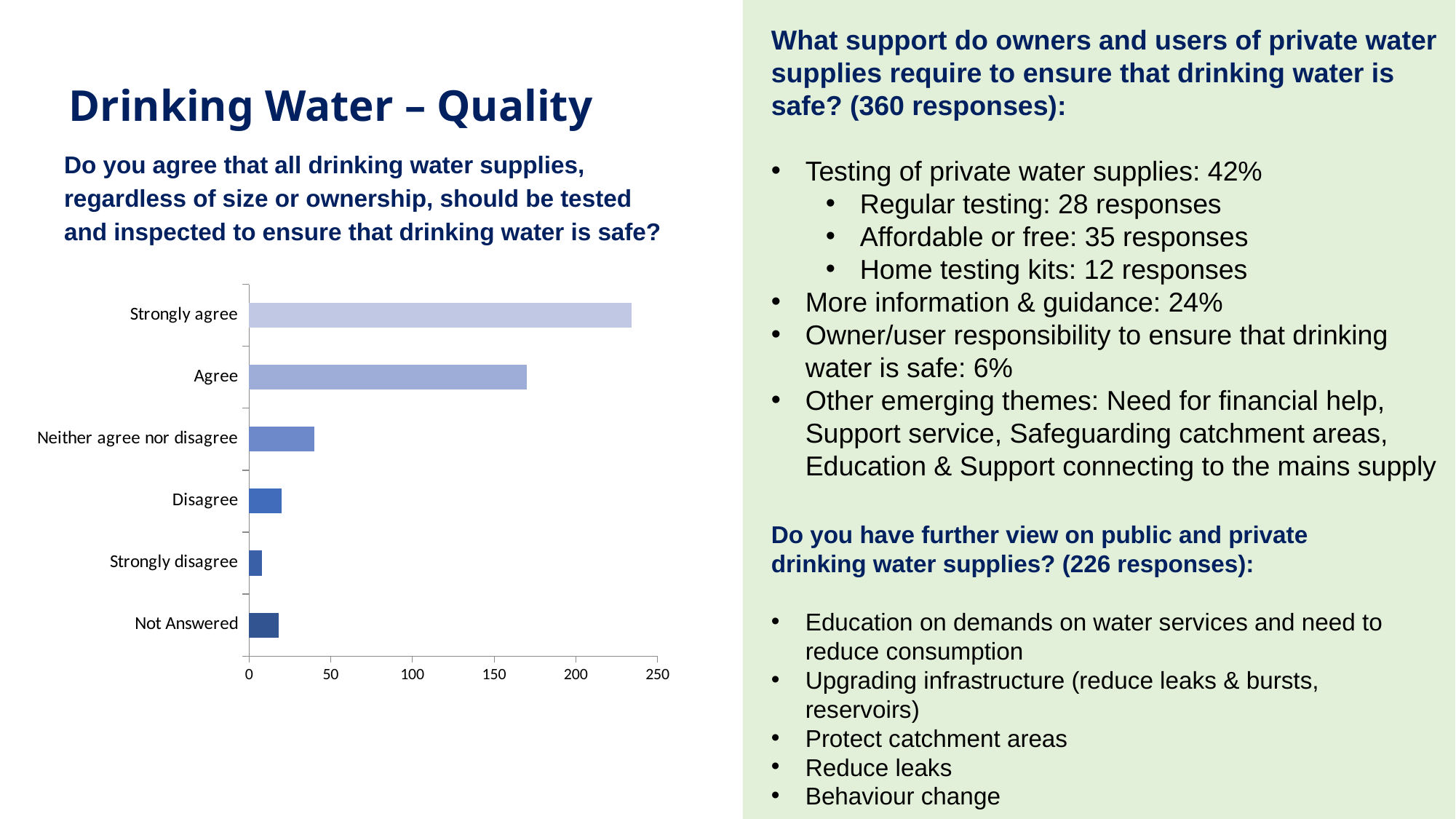
Which is larger on the bar chart, Agree or Neither agree nor disagree? Agree Which category has the highest value on the bar chart? Strongly agree Which category has the lowest value on the bar chart? Strongly disagree Is the value for Strongly agree greater or less than 200? greater What kind of chart is shown on the slide? bar chart How many categories are shown on the bar chart? 6 Is the value for Agree greater or less than 150? greater Which is larger on the bar chart, Strongly agree or Agree? Strongly agree What is the highest value shown on the x axis of the bar chart? 250 Is the value for Disagree greater or less than 50? less Which category is listed at the bottom of the bar chart? Not Answered